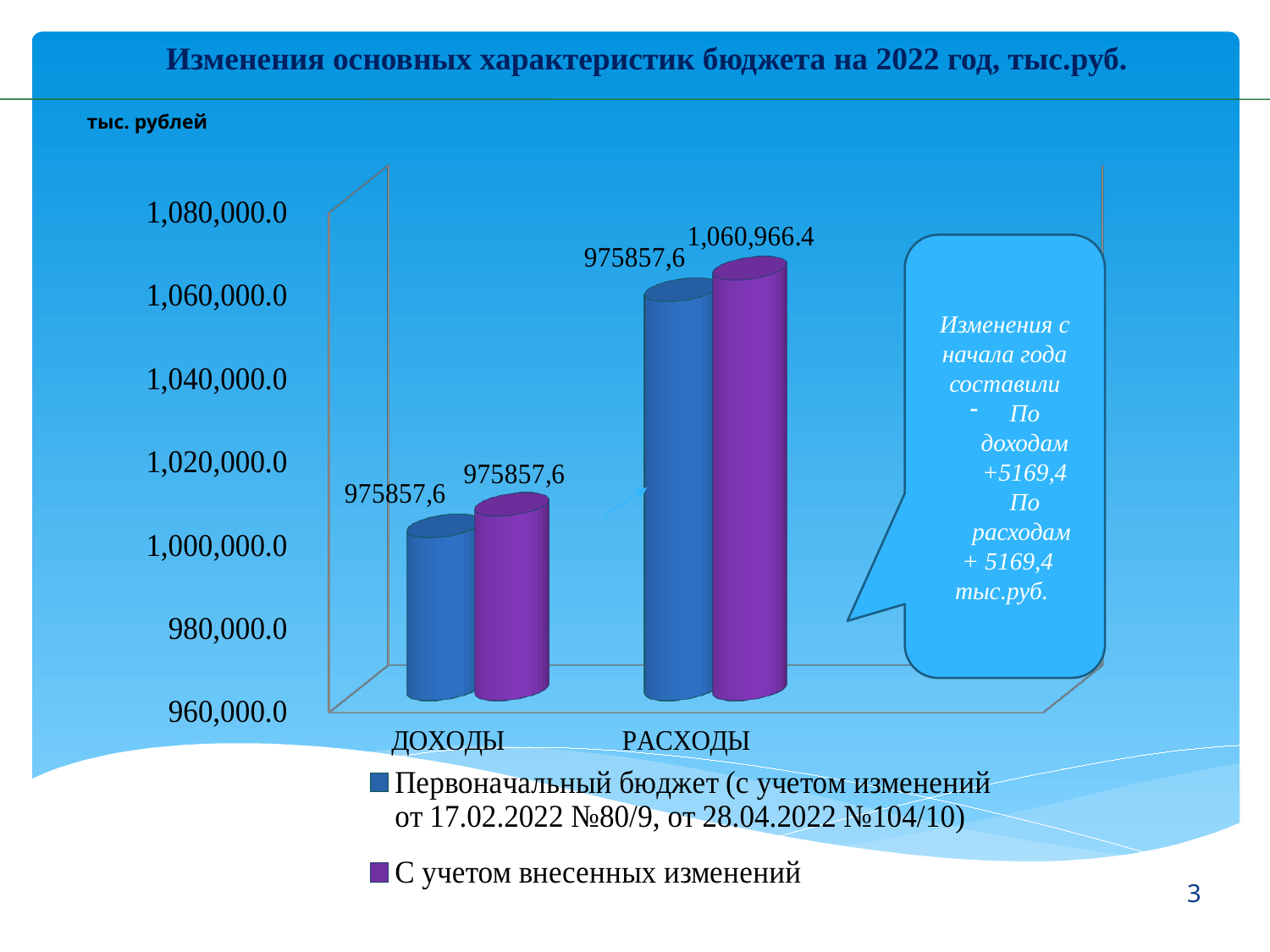
How many categories are shown on the x axis of the chart? 2 What is the value for РАСХОДЫ in the series 'С учетом внесенных изменений'? 1,060,966.4 In the series 'С учетом внесенных изменений', which category has the larger value, ДОХОДЫ or РАСХОДЫ? РАСХОДЫ Is the value for ДОХОДЫ in the series 'Первоначальный бюджет' greater or less than 1,020,000.0? less Is the value for РАСХОДЫ in the series 'С учетом внесенных изменений' greater or less than 1,040,000.0? greater Which bar in the chart is the highest? РАСХОДЫ, С учетом внесенных изменений What value is labelled for ДОХОДЫ in the series 'С учетом внесенных изменений'? 975857,6 What is the unit label shown above the vertical axis of the chart? тыс. рублей What is the title of the chart? Изменения основных характеристик бюджета на 2022 год, тыс.руб. How many series does the chart legend list? 2 Which colour represents the series 'С учетом внесенных изменений' in the chart? purple What type of chart is shown on the slide? bar chart